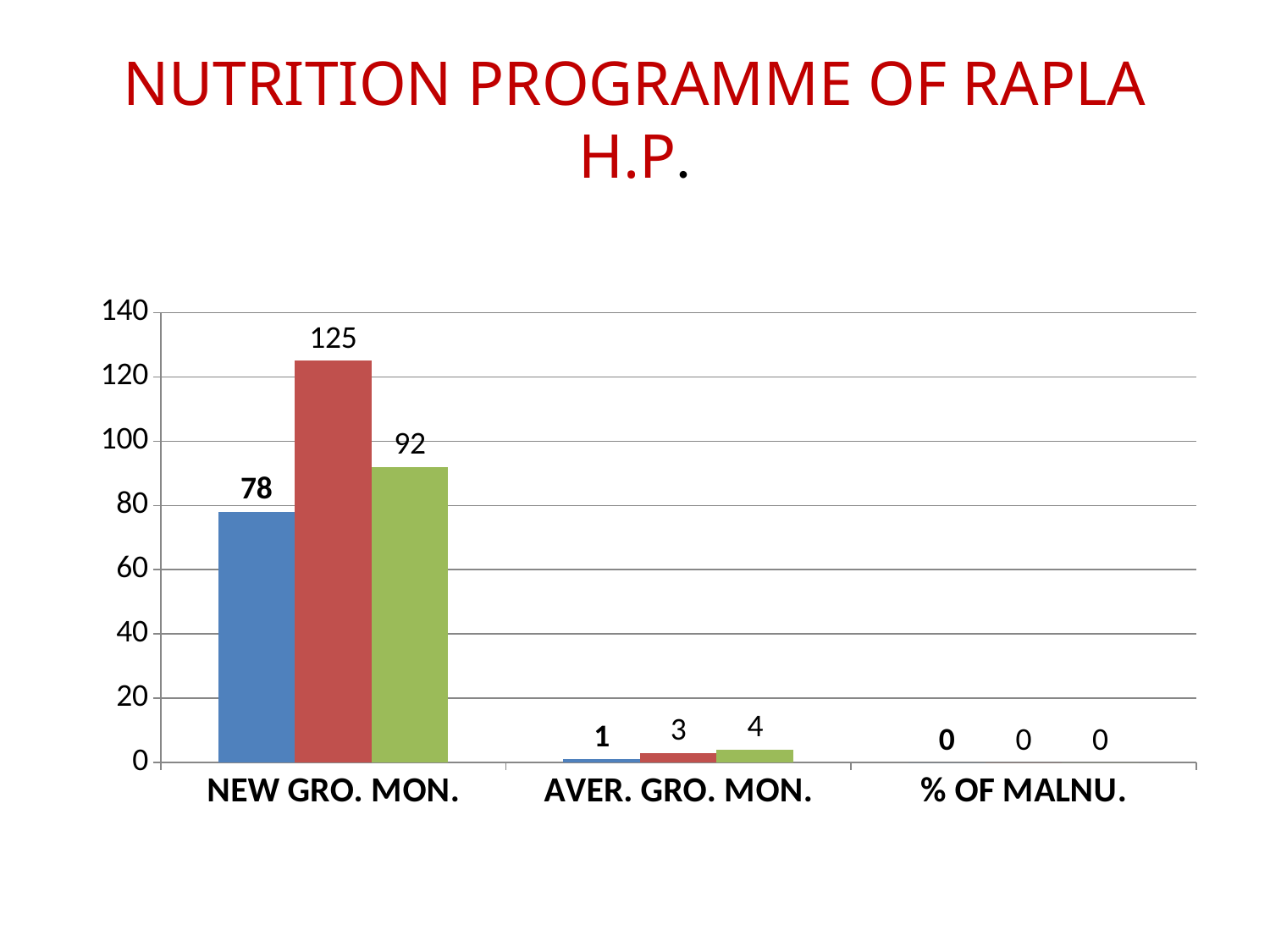
What is the value of the red bar for NEW GRO. MON.? 125 What is the title of the slide containing the chart? NUTRITION PROGRAMME OF RAPLA H.P. How many categories are shown on the x axis? 3 What is the difference between the red and blue bars for NEW GRO. MON.? 47 Which bar has the highest value on the chart? The red bar for NEW GRO. MON. (125) What is the value of the green bar for NEW GRO. MON.? 92 Which is larger for NEW GRO. MON., the green bar or the blue bar? The green bar What kind of chart is shown on the slide? Bar chart What is the value of the blue bar for NEW GRO. MON.? 78 What is the value of the red bar for AVER. GRO. MON.? 3 What is the value of the green bar for AVER. GRO. MON.? 4 What is the value of the blue bar for % OF MALNU.? 0